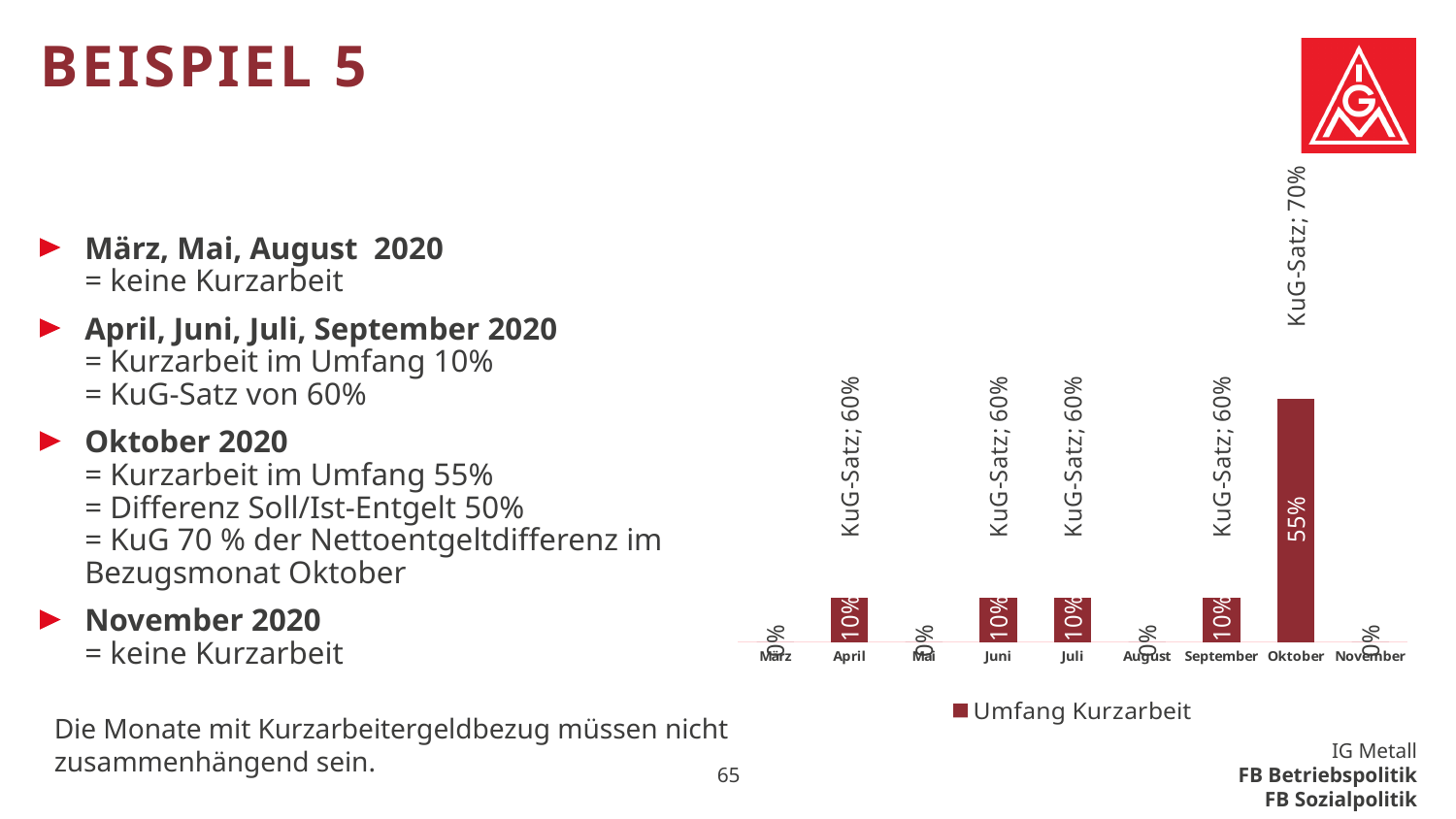
What is the name of the series in the chart legend? Umfang Kurzarbeit What KuG-Satz is labelled above the Juli bar? 60% Which is larger, the value for Juni or the value for Mai? Juni What is the value for April in the chart? 10% How many months are shown on the x axis of the chart? 9 What kind of chart is shown on the slide? bar chart What is the value for August in the chart? 0% What is the value for Oktober in the chart? 55% What is the difference between the values for Oktober and September? 45% How many series does the legend list? 1 What KuG-Satz is labelled above the Oktober bar? 70% Which month has the highest value in the chart? Oktober